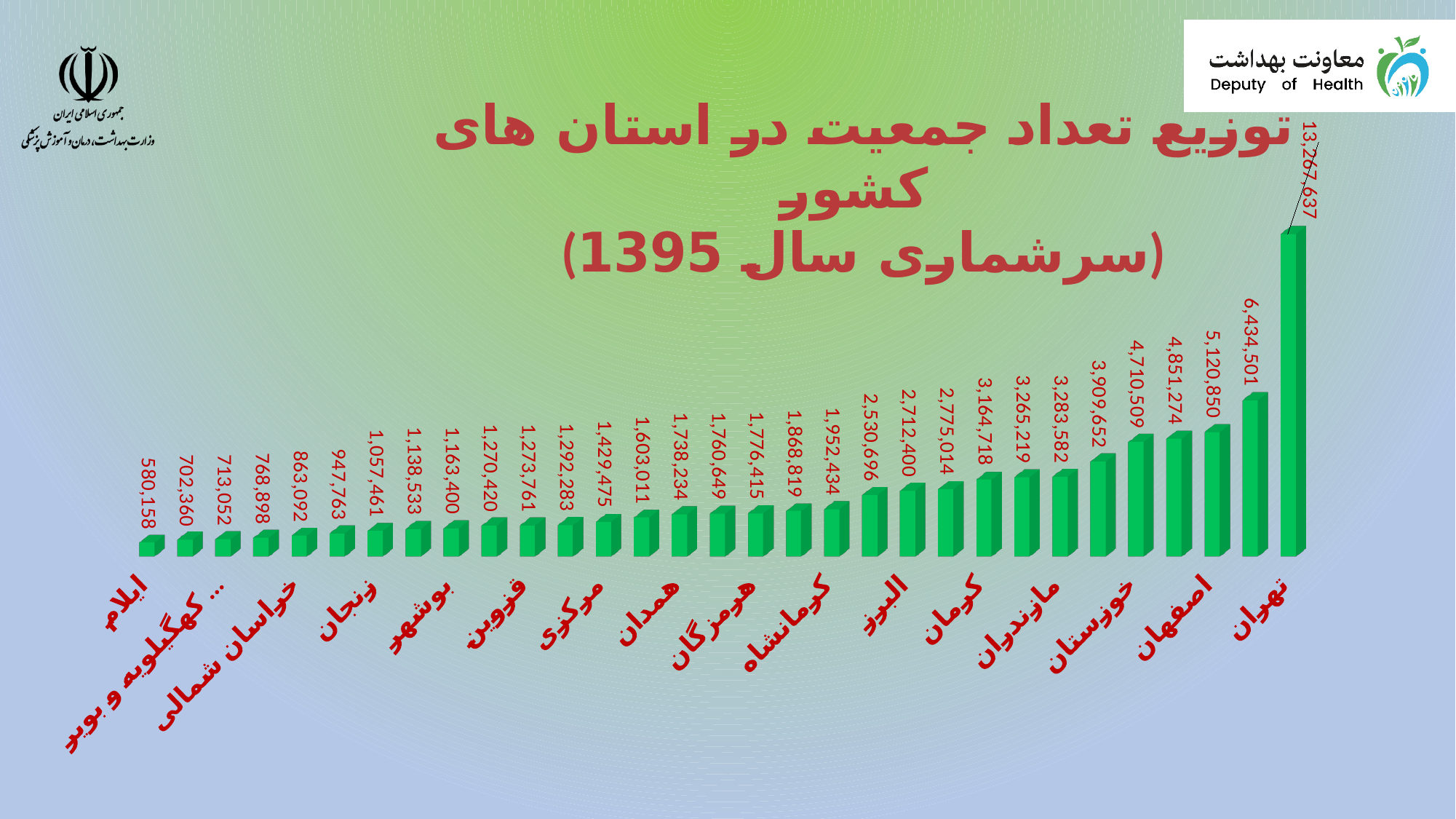
What type of chart is shown on the slide? bar chart Do the values rise or fall from left to right along the x axis? rise Which province has the lowest population in the chart? ایلام What is the difference between the populations of تهران and اصفهان? 8,146,787 What is the population value shown for ایلام? 580,158 What is the population value shown for اصفهان? 5,120,850 What is the population value shown for البرز? 2,712,400 Which province has the highest population in the chart? تهران What is the population value shown for تهران? 13,267,637 What is the population value shown for خوزستان? 4,710,509 Which has a larger population, خوزستان or مازندران? خوزستان How many bars are plotted in the chart? 31